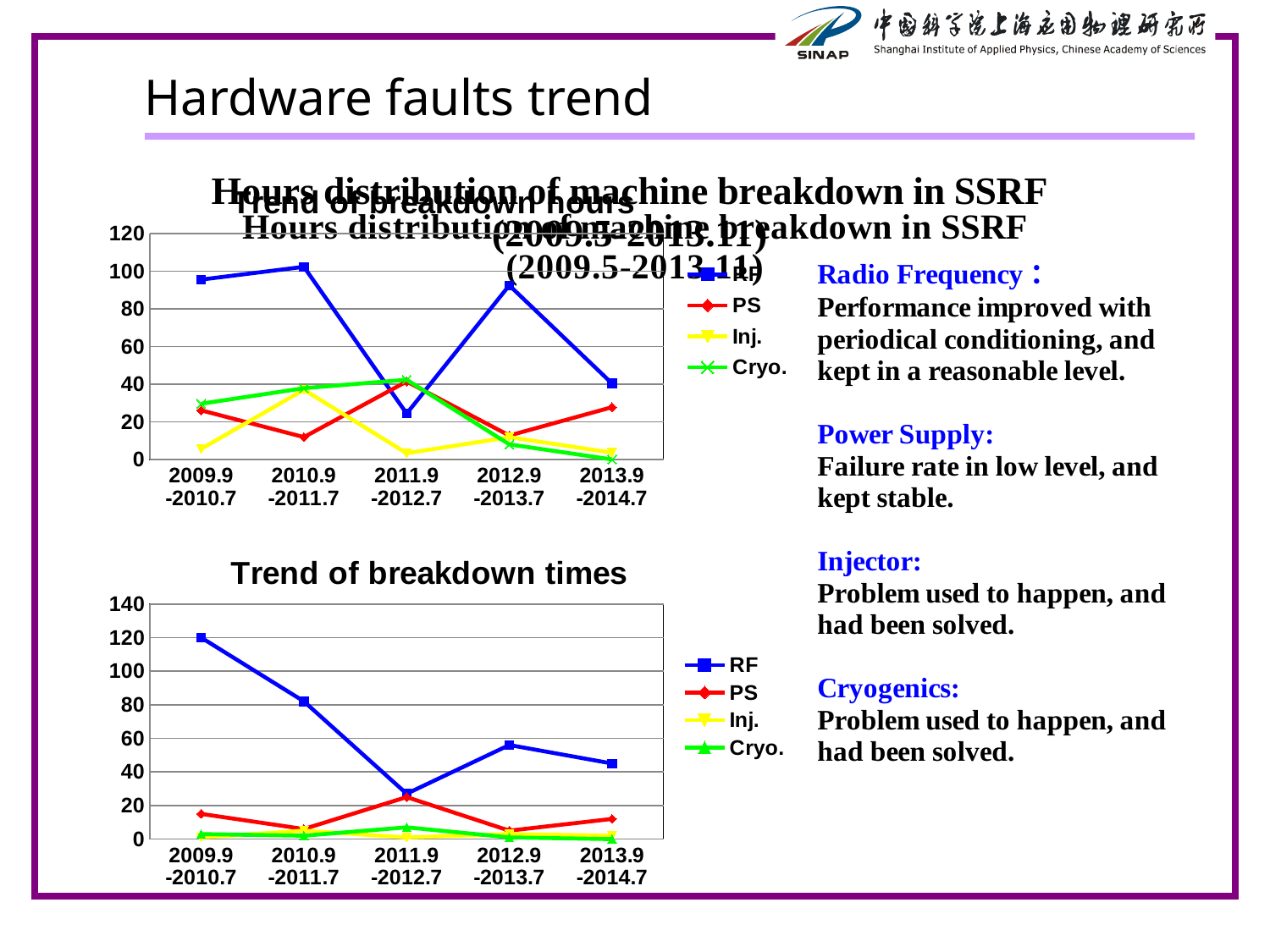
In the bottom chart, in which period is the RF series highest? 2009.9-2010.7 In the bottom chart, does the RF series rise or fall from 2009.9-2010.7 to 2011.9-2012.7? fall What type of chart is the top chart on the slide? line chart In the bottom chart, which is larger for 2012.9-2013.7: RF or PS? RF In the top chart, in which period is the RF series lowest? 2011.9-2012.7 In the bottom chart, is the RF value for 2009.9-2010.7 greater or less than 100? greater In the top chart, is the RF value for 2011.9-2012.7 greater or less than 40? less In the bottom chart, is the RF value for 2011.9-2012.7 greater or less than 40? less How many series does the legend of the bottom chart list? 4 How many time periods are shown on the x axis of the bottom chart? 5 What is the title of the bottom chart? Trend of breakdown times